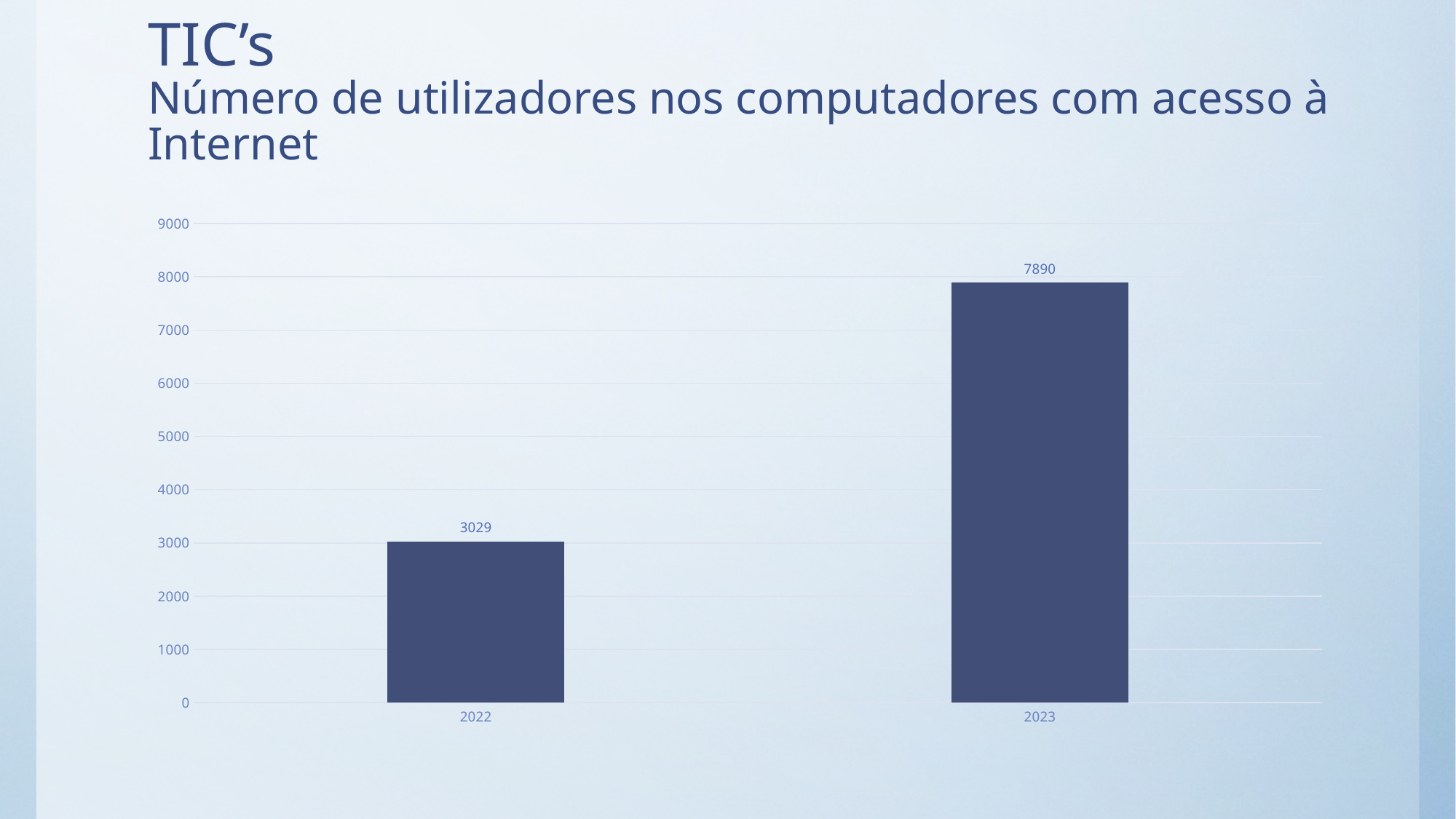
What is the difference between the values for 2023 and 2022? 4861 What is the maximum value shown on the y axis? 9000 Which is larger, the value for 2022 or the value for 2023? 2023 Which year has the lowest value? 2022 What kind of chart is shown on the slide? bar chart Is the value for 2023 greater or less than 7000? greater What is the value for 2023? 7890 Is the value for 2022 greater or less than 4000? less Which year has the highest value? 2023 How many categories are shown on the x axis? 2 Do the values rise or fall from 2022 to 2023? rise What is the value for 2022? 3029